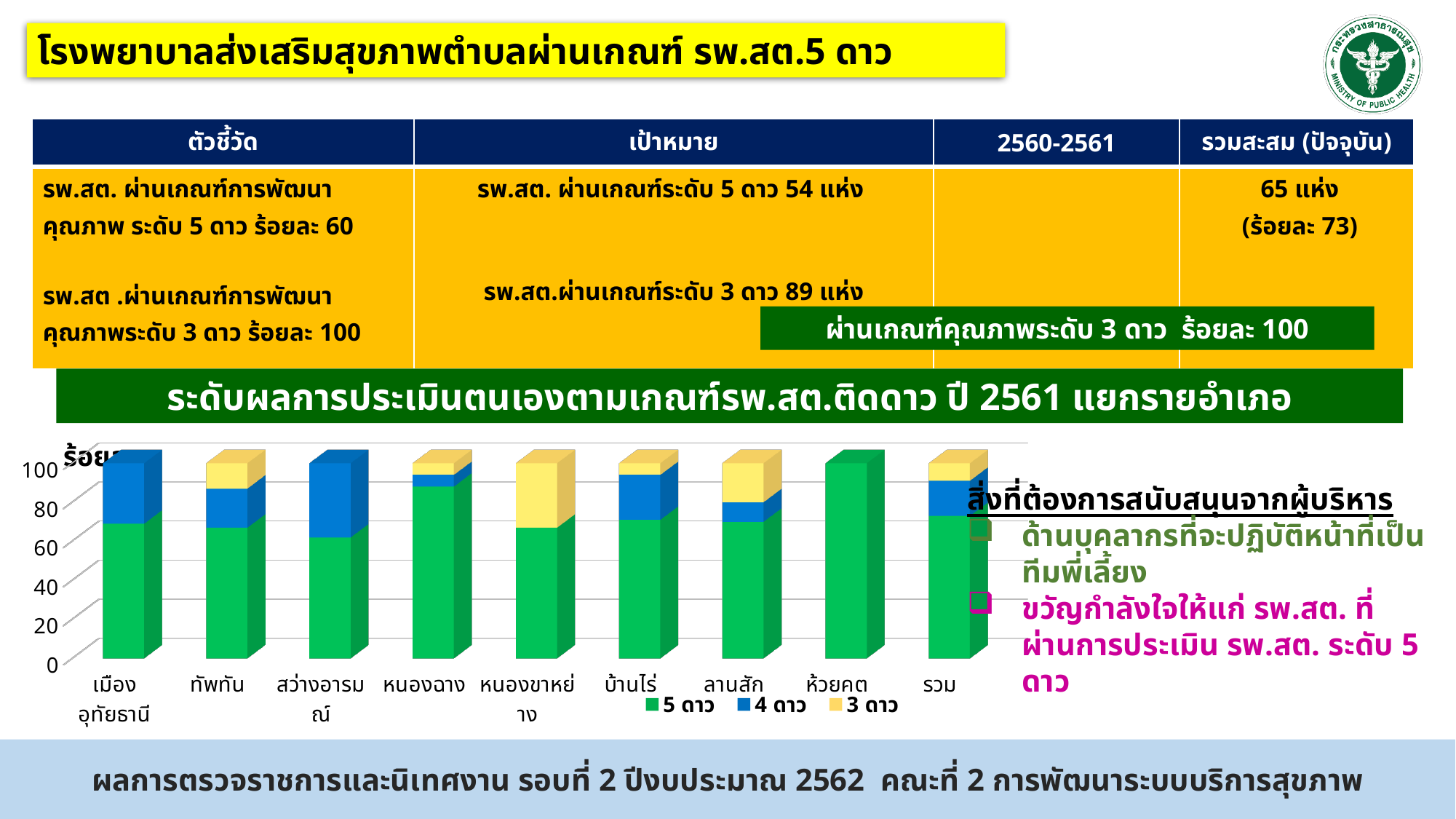
Is the 5 ดาว value for ลานสัก greater or less than 80? less Is the 5 ดาว value for หนองฉาง greater or less than 80? greater What are the three series listed in the chart legend? 5 ดาว, 4 ดาว, 3 ดาว Which district has the highest 5 ดาว value in the chart? ห้วยคต What kind of chart is shown on the slide? stacked bar chart How many series does the chart legend list? 3 How many districts (categories) are shown on the x axis of the chart? 9 Which has the larger 5 ดาว value, หนองฉาง or หนองขาหย่าง? หนองฉาง Which series is shown in green in the chart? 5 ดาว Is the 5 ดาว value for หนองขาหย่าง greater or less than 80? less Which district has the largest 3 ดาว segment in the chart? หนองขาหย่าง